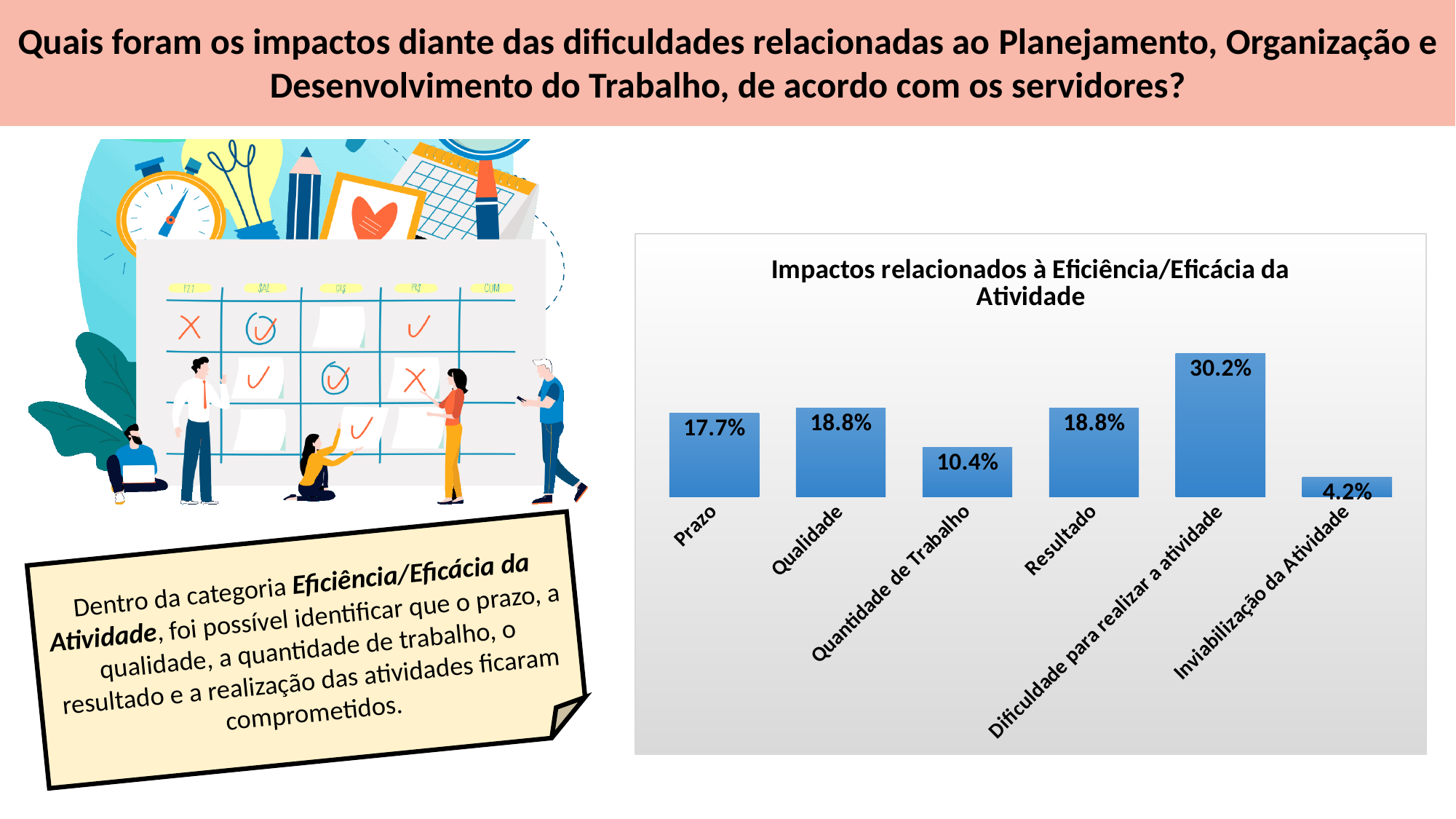
Which category has the lowest value? Inviabilização da Atividade Which is larger, the value for Prazo or the value for Quantidade de Trabalho? Prazo What kind of chart is shown on the slide? Bar chart What is the value for Quantidade de Trabalho? 10.4% What is the value for Inviabilização da Atividade? 4.2% What is the value for Prazo? 17.7% What is the value for Qualidade? 18.8% What is the difference between the values for Resultado and Quantidade de Trabalho? 8.4% Which category has the highest value? Dificuldade para realizar a atividade What is the difference between the values for Dificuldade para realizar a atividade and Prazo? 12.5% What is the title of the chart? Impactos relacionados à Eficiência/Eficácia da Atividade How many categories are shown in the chart? 6